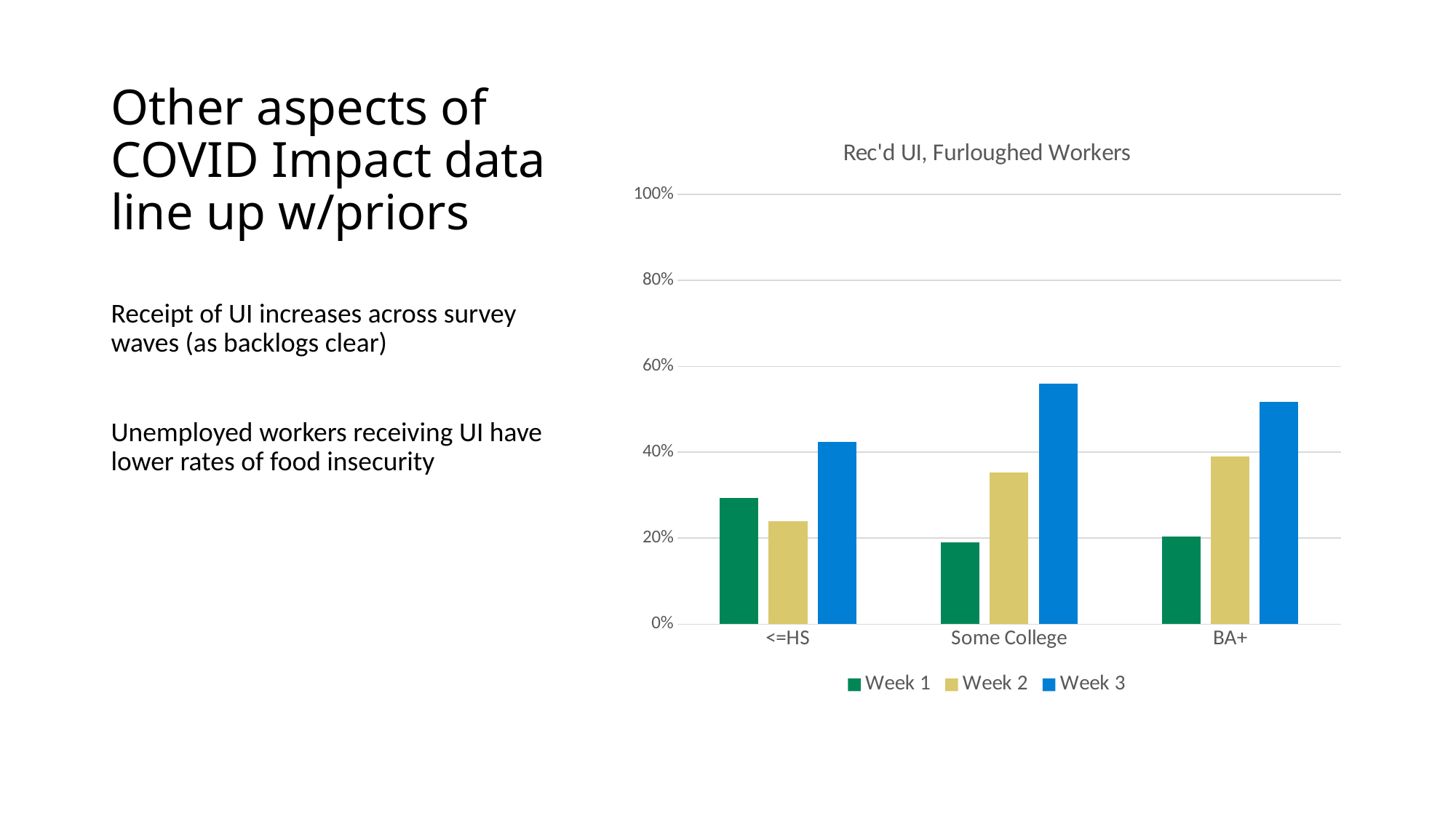
How many series does the legend list? 3 How many categories are shown on the x axis? 3 Is the Week 2 value for Some College greater or less than 40%? less For <=HS, which is larger: the Week 1 value or the Week 2 value? Week 1 What is the title of the chart? Rec'd UI, Furloughed Workers Which is larger: the Week 3 value for <=HS or the Week 3 value for BA+? BA+ Do the Week 2 values rise or fall moving from <=HS to BA+ along the x axis? rise Is the Week 3 value for <=HS greater or less than 40%? greater Is the Week 3 value for Some College greater or less than 60%? less What kind of chart is shown on the slide? Bar chart Which category has the highest Week 3 value? Some College Which category has the lowest Week 2 value? <=HS